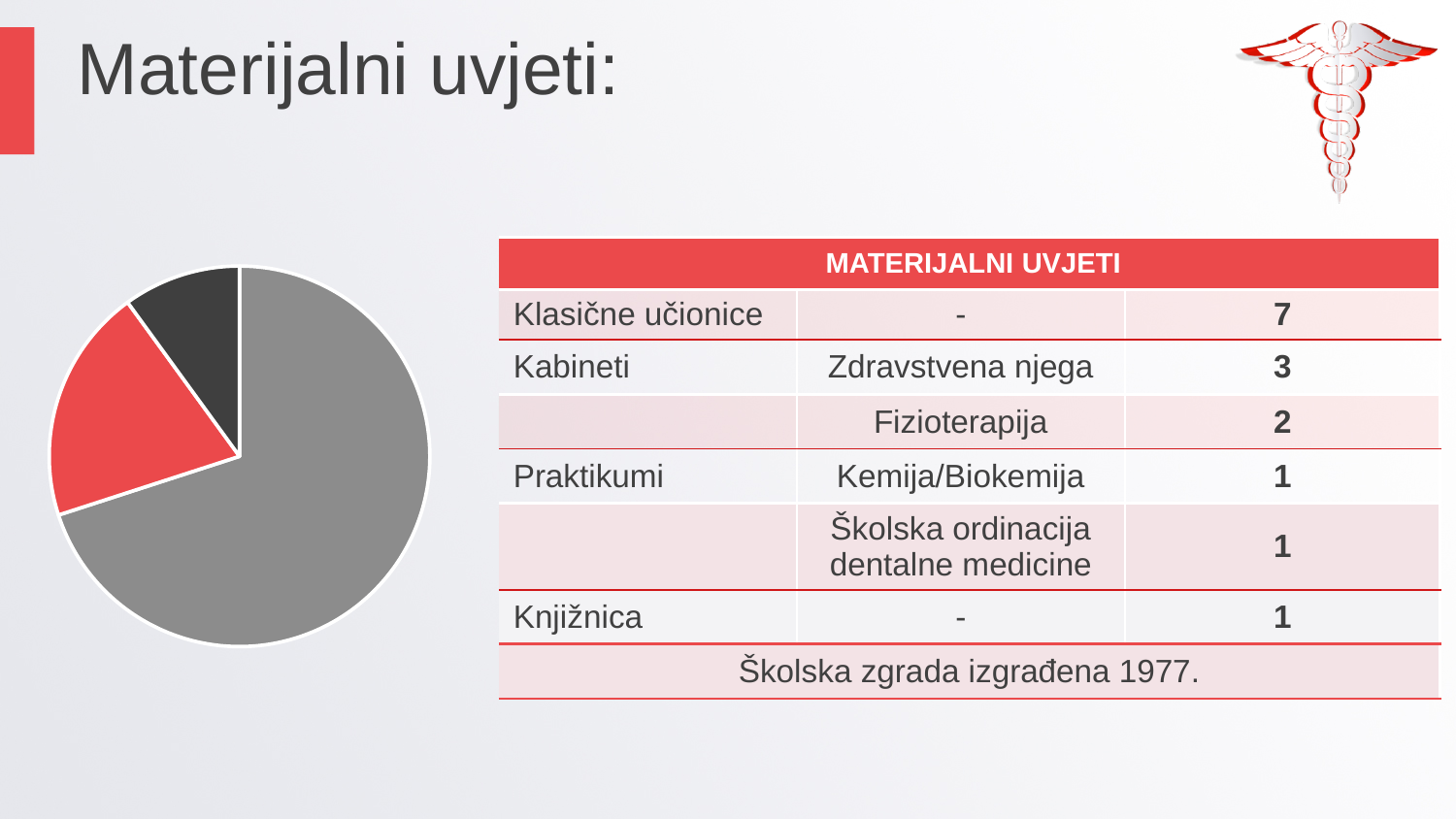
Does the pie chart display a legend? No What kind of chart is shown on the left of the slide? pie chart In the pie chart, which slice is larger, the red one or the dark gray one? red Which colour slice is the smallest in the pie chart? dark gray Which colour slice is the largest in the pie chart? gray Does the gray slice of the pie chart take up more or less than half of the pie? more Does the pie chart show data labels on its slices? No How many slices does the pie chart have? 3